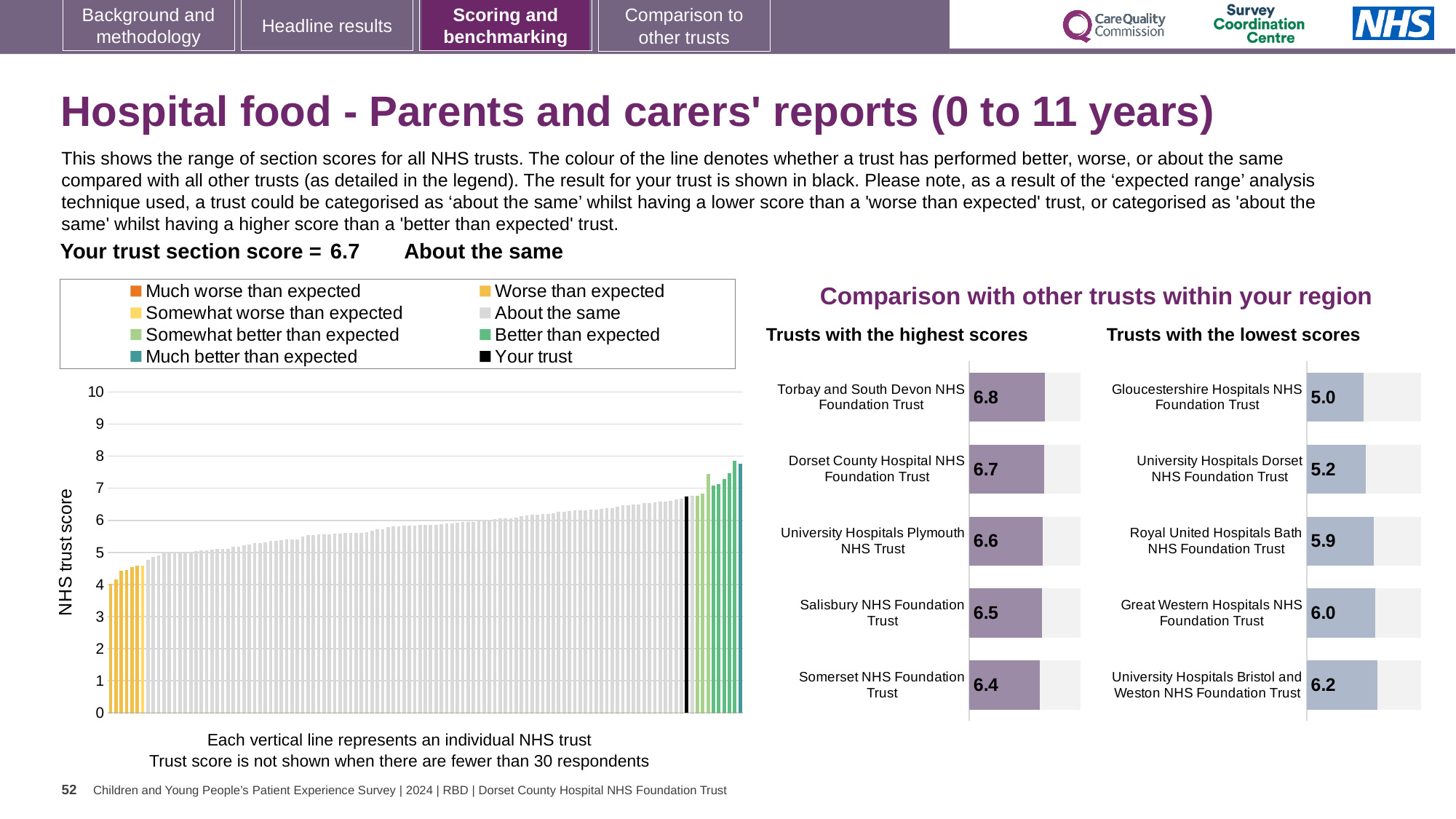
In the 'Trusts with the lowest scores' chart, which trust has the highest score? University Hospitals Bristol and Weston NHS Foundation Trust In the 'Trusts with the highest scores' chart, what is the difference between the scores of Torbay and South Devon NHS Foundation Trust and Somerset NHS Foundation Trust? 0.4 In the 'Trusts with the highest scores' chart, what is the score for Torbay and South Devon NHS Foundation Trust? 6.8 In the 'Trusts with the lowest scores' chart, what is the score for Gloucestershire Hospitals NHS Foundation Trust? 5.0 In the 'Trusts with the lowest scores' chart, which has the larger score: University Hospitals Dorset NHS Foundation Trust or Great Western Hospitals NHS Foundation Trust? Great Western Hospitals NHS Foundation Trust How many trusts are shown in the 'Trusts with the highest scores' chart? 5 In the main 'NHS trust score' chart, do the bar values rise or fall from left to right? rise In the 'Trusts with the lowest scores' chart, what is the difference between the scores of Royal United Hospitals Bath NHS Foundation Trust and Gloucestershire Hospitals NHS Foundation Trust? 0.9 In the main 'NHS trust score' chart, is the value for the black 'Your trust' bar greater or less than 6? greater How many entries does the legend of the main 'NHS trust score' chart list? 8 In the 'Trusts with the highest scores' chart, which trust has the lowest score? Somerset NHS Foundation Trust What kind of chart is the main 'NHS trust score' chart? bar chart